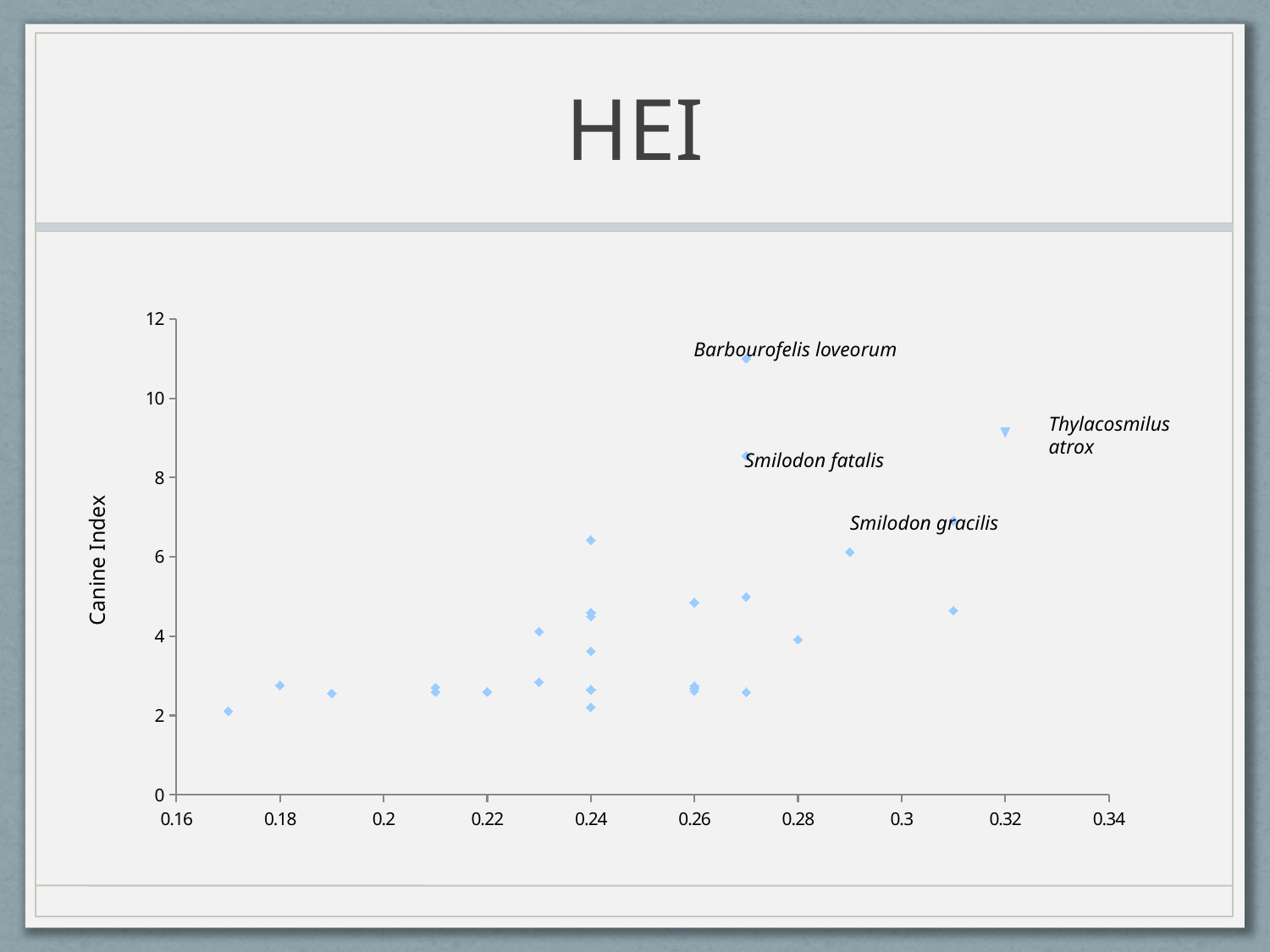
Is the Canine Index for Smilodon fatalis greater or less than 8? greater Which labeled species has the highest Canine Index? Barbourofelis loveorum Do the Canine Index values generally rise or fall as the x-axis value increases? rise What kind of chart is shown on the slide? scatter plot Is the Canine Index for Thylacosmilus atrox greater or less than 8? greater How many species are labeled by name on the chart? 4 What is the title of the slide/chart? HEI Which has the higher Canine Index, Barbourofelis loveorum or Thylacosmilus atrox? Barbourofelis loveorum Is the Canine Index for Barbourofelis loveorum greater or less than 10? greater Which labeled species is plotted furthest to the right on the x axis? Thylacosmilus atrox What is the label on the vertical axis? Canine Index